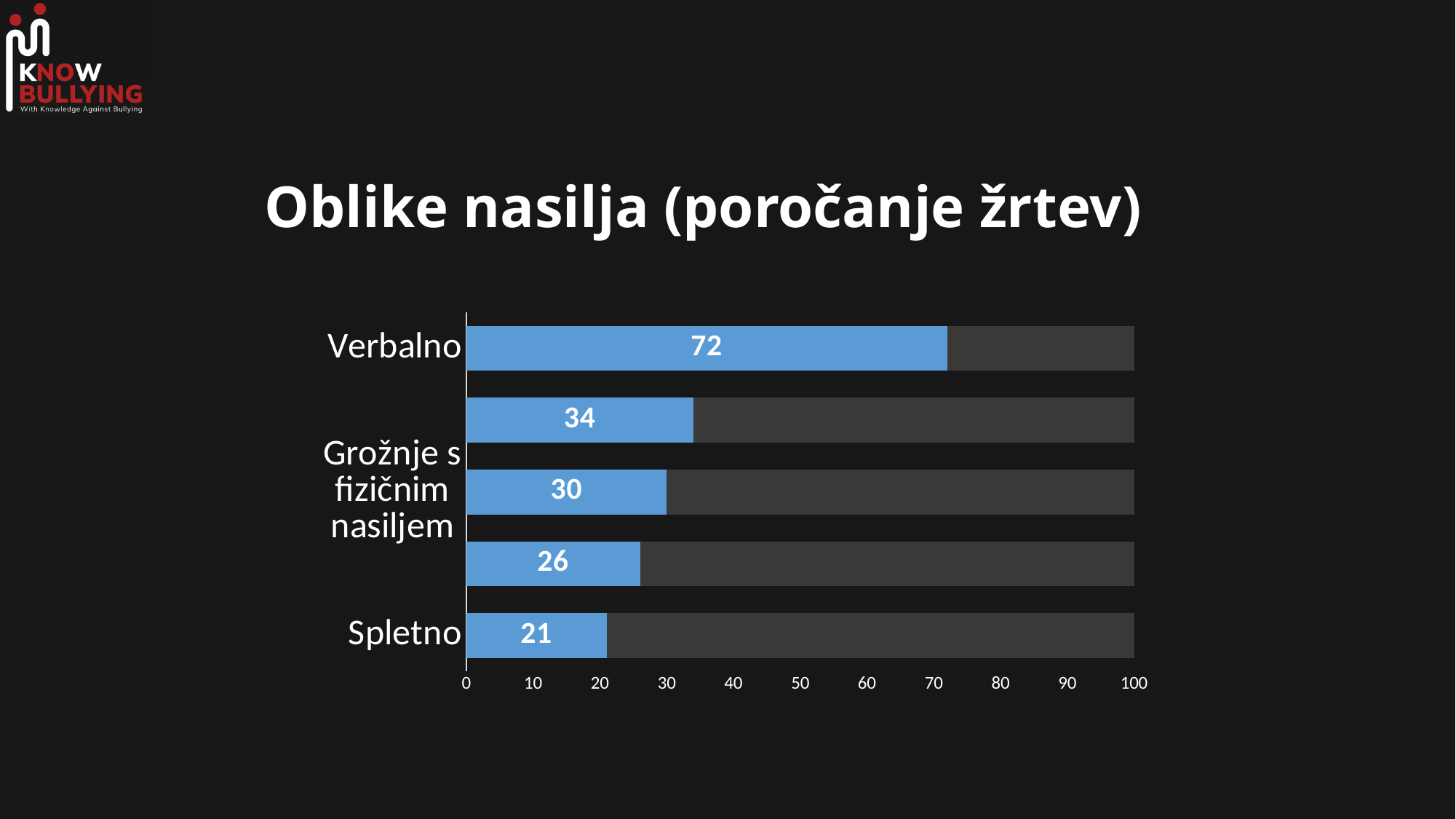
What kind of chart is shown on the slide? bar chart What is the difference between the values for Grožnje s fizičnim nasiljem and Spletno? 9 What is the value for Grožnje s fizičnim nasiljem? 30 Which category has the highest value? Verbalno How many bars are plotted in the chart? 5 What is the value for Verbalno? 72 Which is larger, the value for Verbalno or the value for Grožnje s fizičnim nasiljem? Verbalno Which category has the lowest value? Spletno What is the difference between the values for Verbalno and Spletno? 51 Is the value for Verbalno greater or less than 70? greater What is the title of the slide? Oblike nasilja (poročanje žrtev) What is the value for Spletno? 21